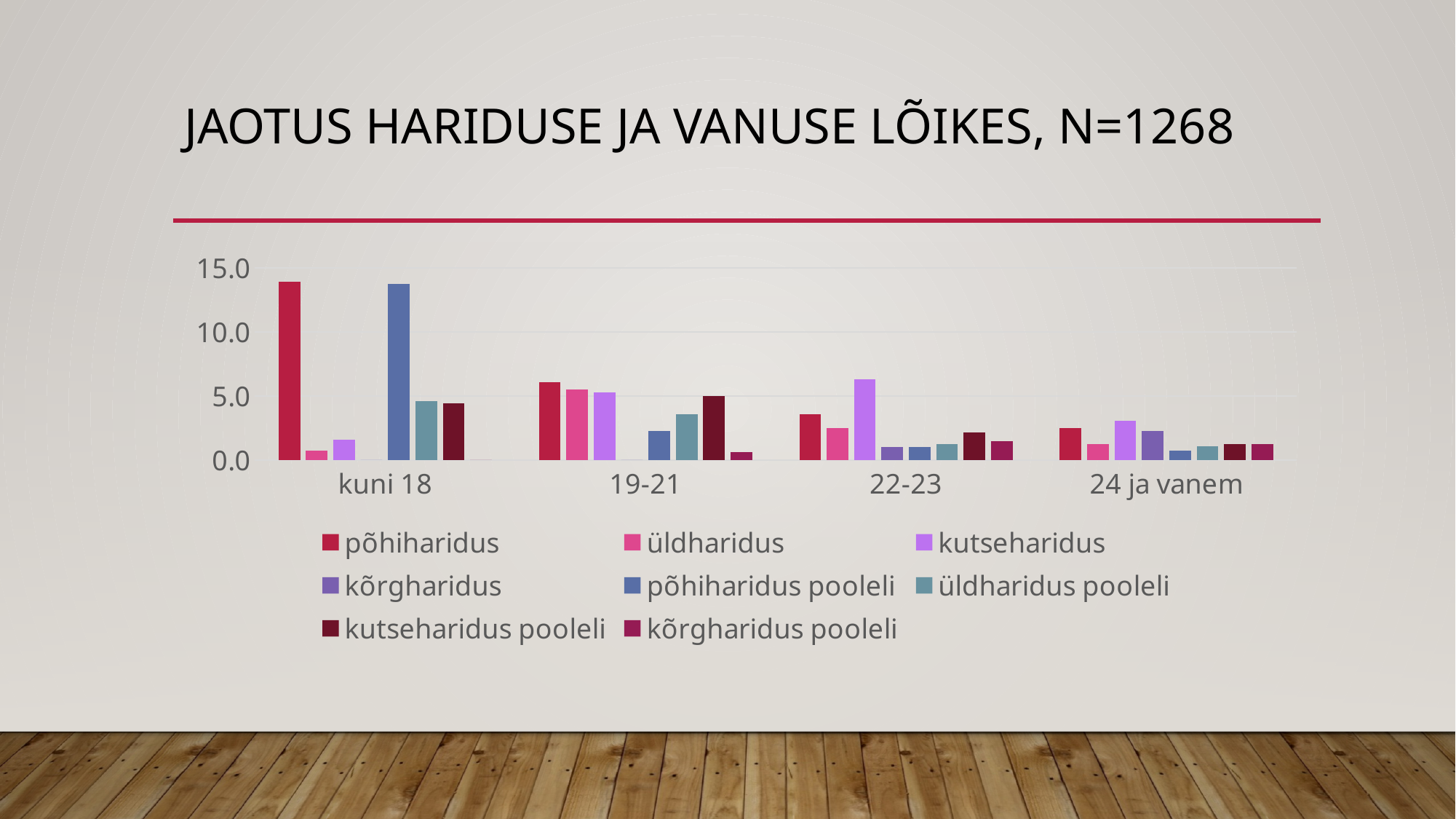
Is the value for kõrgharidus in the 24 ja vanem group greater or less than 5.0? less Is the value for kutseharidus in the 22-23 group greater or less than 5.0? greater Which is larger: põhiharidus for kuni 18 or põhiharidus for 19-21? kuni 18 Which is larger: kutseharidus for kuni 18 or kutseharidus for 22-23? 22-23 How many series does the legend list? 8 Which series has the highest value in the 22-23 group? kutseharidus What is the title of the chart on the slide? JAOTUS HARIDUSE JA VANUSE LÕIKES, N=1268 Is the value for põhiharidus in the kuni 18 group greater or less than 10.0? greater What kind of chart is shown on the slide? bar chart How many age-group categories are shown on the x axis? 4 Do the values for põhiharidus rise or fall from kuni 18 to 24 ja vanem? fall